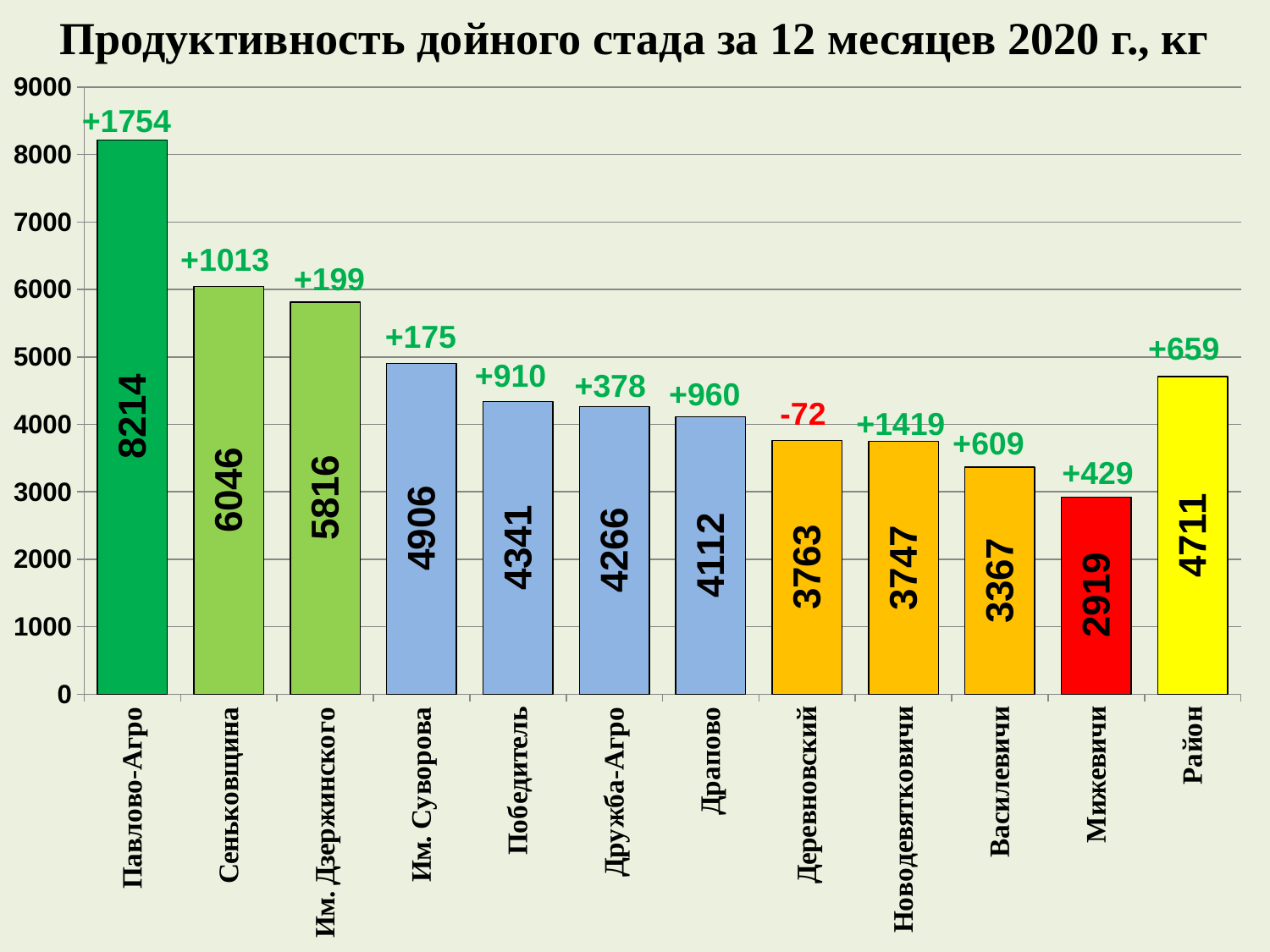
What is the value for Район? 4711 Is the value for Им. Суворова greater or less than 5000? less Which category has the lowest value? Мижевичи What kind of chart is shown on the slide? bar chart How many categories are shown on the x axis? 12 What is the value for Новодевятковичи? 3747 What is the title of the chart? Продуктивность дойного стада за 12 месяцев 2020 г., кг What change figure is printed above the bar for Деревновский? -72 What is the difference between the values for Сеньковщина and Им. Дзержинского? 230 Which category has the highest value? Павлово-Агро Which is larger, the value for Победитель or the value for Дружба-Агро? Победитель What is the value for Павлово-Агро? 8214